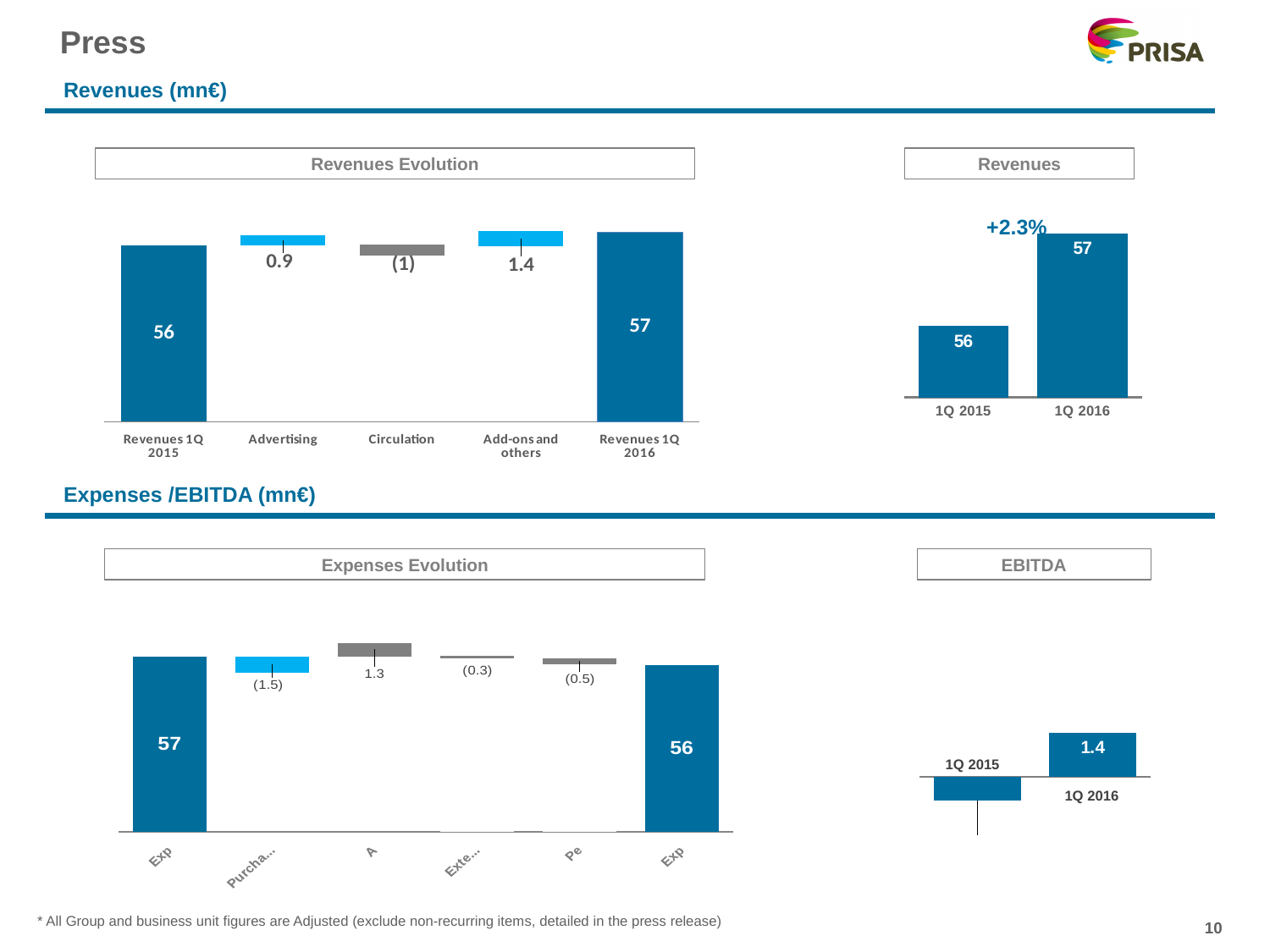
In the Revenues Evolution chart, what is the value for Add-ons and others? 1.4 In the Expenses Evolution chart, what is the value of the first bar on the left? 57 In the Revenues chart, what is the value for 1Q 2016? 57 In the Revenues Evolution chart, what is the value for Revenues 1Q 2015? 56 In the Expenses Evolution chart, what is the value of the last bar on the right? 56 In the Revenues chart, what percentage change is shown between 1Q 2015 and 1Q 2016? +2.3% In the EBITDA chart, what is the value for 1Q 2016? 1.4 In the Revenues Evolution chart, what is the value for Advertising? 0.9 In the Revenues chart, what is the difference between 1Q 2016 and 1Q 2015? 1 In the Revenues Evolution chart, what is the value for Circulation? (1) In the Revenues Evolution chart, what is the value for Revenues 1Q 2016? 57 How many categories are shown on the x axis of the Revenues Evolution chart? 5